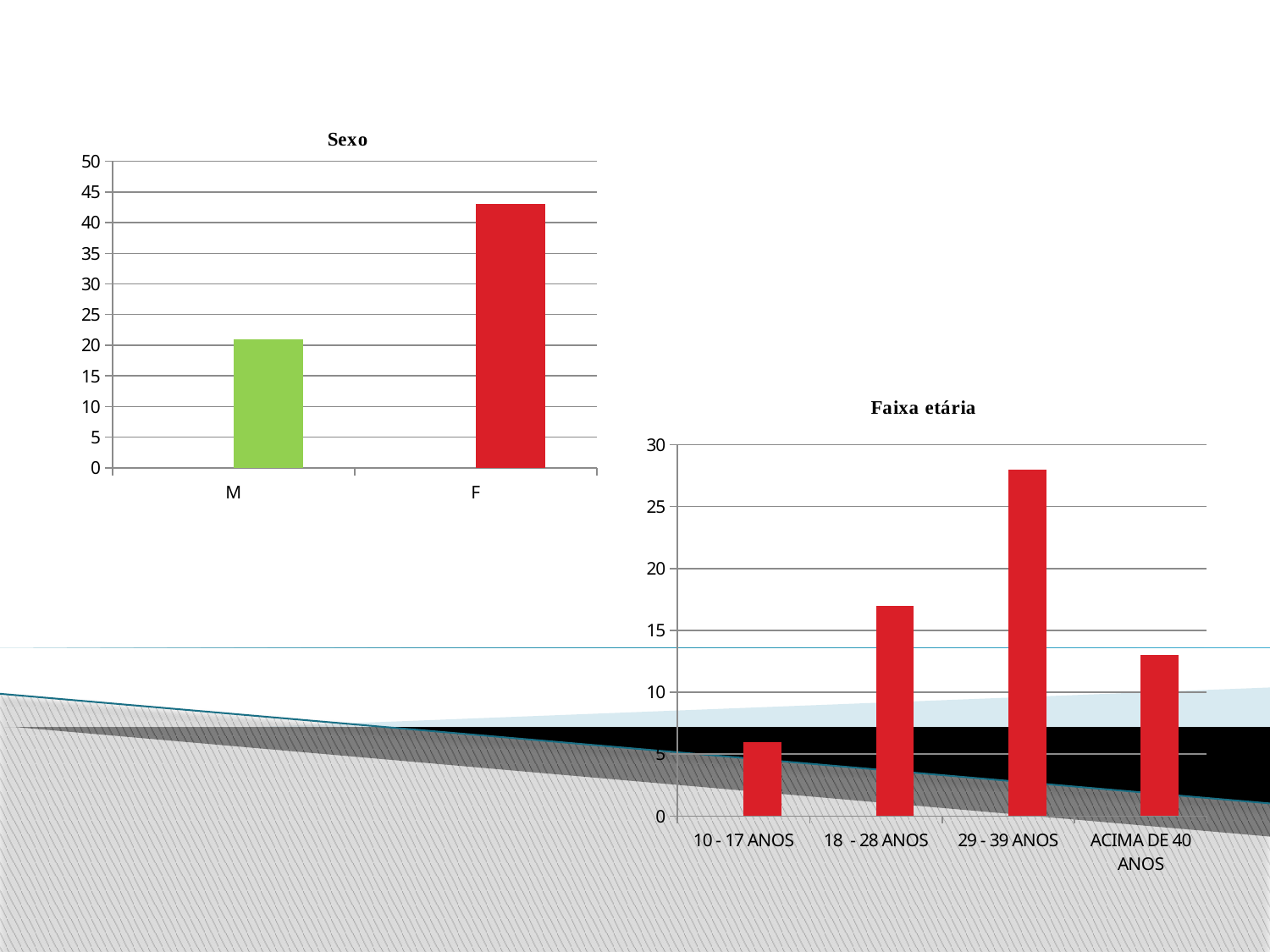
In the 'Faixa etária' chart, which is larger: the value for 18 - 28 ANOS or the value for ACIMA DE 40 ANOS? 18 - 28 ANOS In the 'Faixa etária' chart, how many age groups are shown on the x axis? 4 In the 'Sexo' chart, is the value for M greater or less than 25? less In the 'Faixa etária' chart, which age group has the highest value? 29 - 39 ANOS In the 'Sexo' chart, which category has the highest value? F In the 'Sexo' chart, is the value for F greater or less than 40? greater In the 'Faixa etária' chart, which age group has the lowest value? 10 - 17 ANOS In the 'Faixa etária' chart, is the value for ACIMA DE 40 ANOS greater or less than 15? less In the 'Sexo' chart, which category has the lowest value? M What kind of chart is the 'Sexo' chart? bar chart In the 'Sexo' chart, how many categories are shown on the x axis? 2